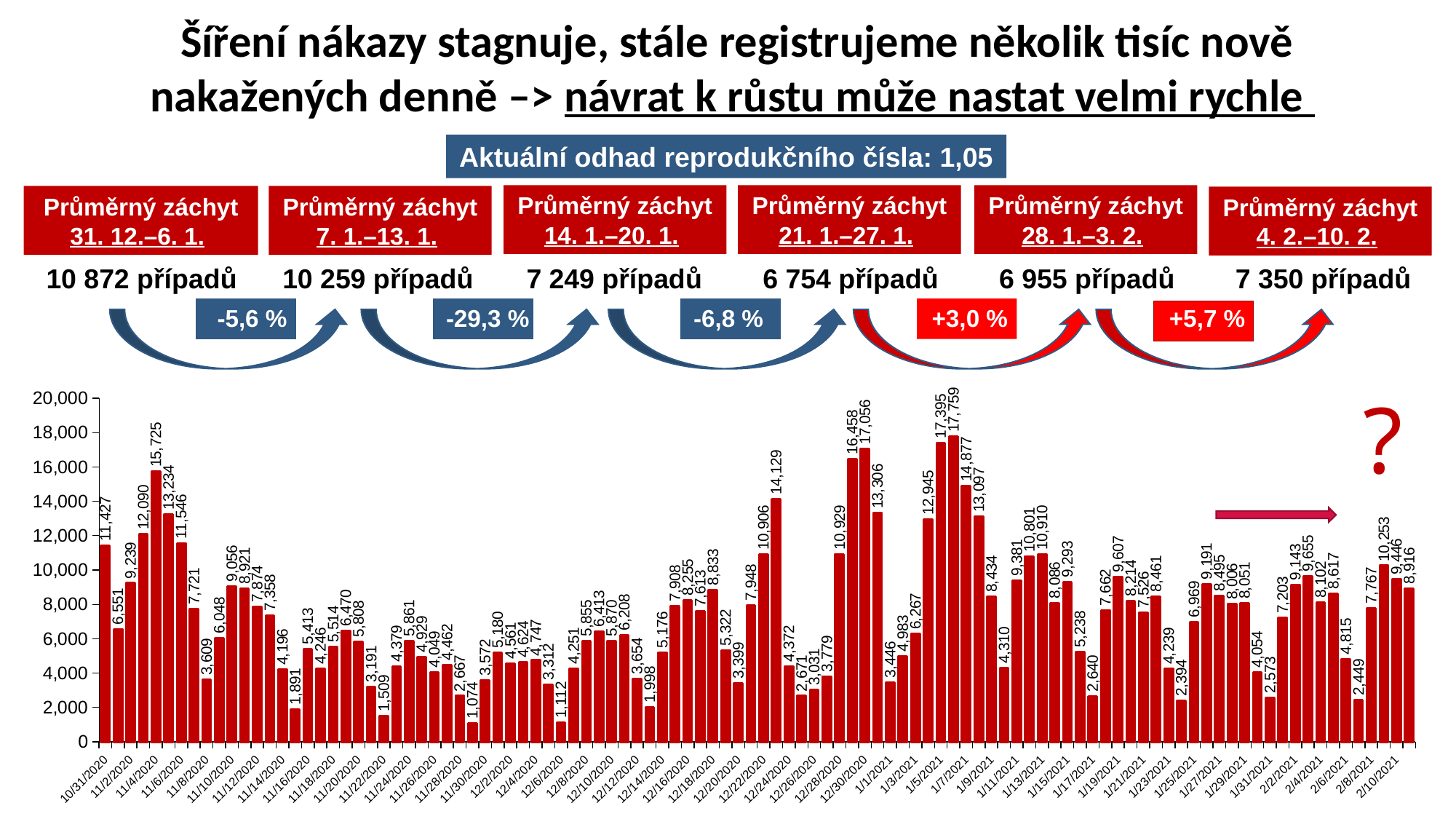
Is the bar labelled 2,394 greater or less than 4,000? less What is the difference between the highest bar (17,759) and the lowest bar (1,074)? 16,685 What kind of chart is shown on the slide? bar chart What is the maximum value shown on the vertical axis of the chart? 20,000 What is the difference between the first two bars, 11,427 and 6,551? 4,876 What is the value of the first bar, for 10/31/2020? 11,427 What is the lowest daily value shown in the bar chart? 1,074 What is the value of the bar for 11/4/2020? 15,725 Is the value of the first bar (10/31/2020) greater or less than 10,000? greater What colour are the bars in the chart? red Which is larger: the bar labelled 15,725 or the bar labelled 14,129? 15,725 What is the highest daily value shown in the bar chart? 17,759